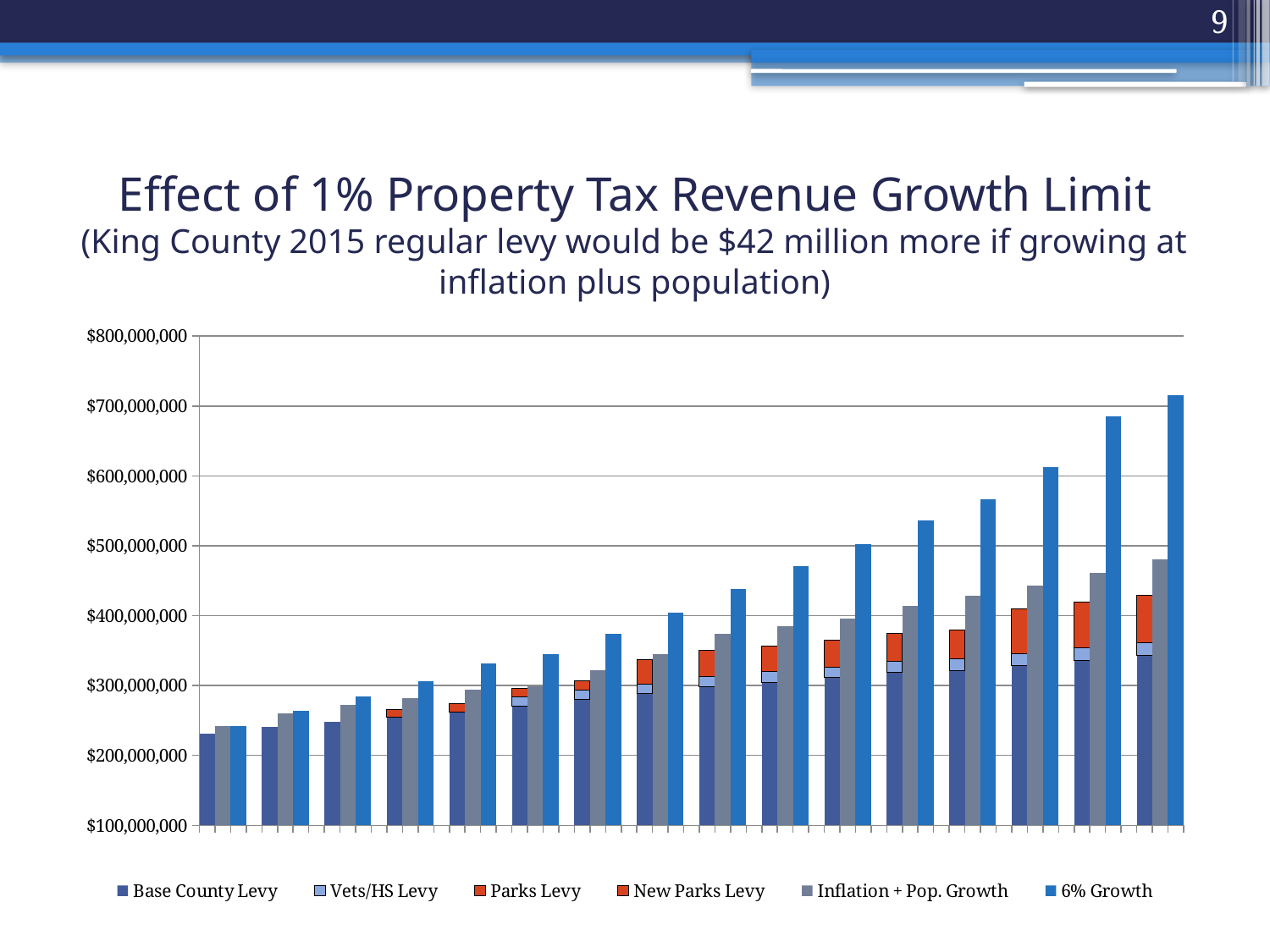
Is the value of the Inflation + Pop. Growth bar in the rightmost group greater or less than $500,000,000? less In the rightmost group, which is larger: the 6% Growth bar or the Inflation + Pop. Growth bar? 6% Growth What is the title of the chart on the slide? Effect of 1% Property Tax Revenue Growth Limit Which series is listed last in the legend? 6% Growth Is the value of the 6% Growth bar in the leftmost group greater or less than $300,000,000? less Is the value of the 6% Growth bar in the rightmost group greater or less than $700,000,000? greater Does the 6% Growth series rise or fall from left to right along the x axis? rise How many series does the legend list? 6 What kind of chart is shown on the slide? bar chart How many groups of bars are plotted along the x axis? 16 Which series reaches the highest value on the chart? 6% Growth